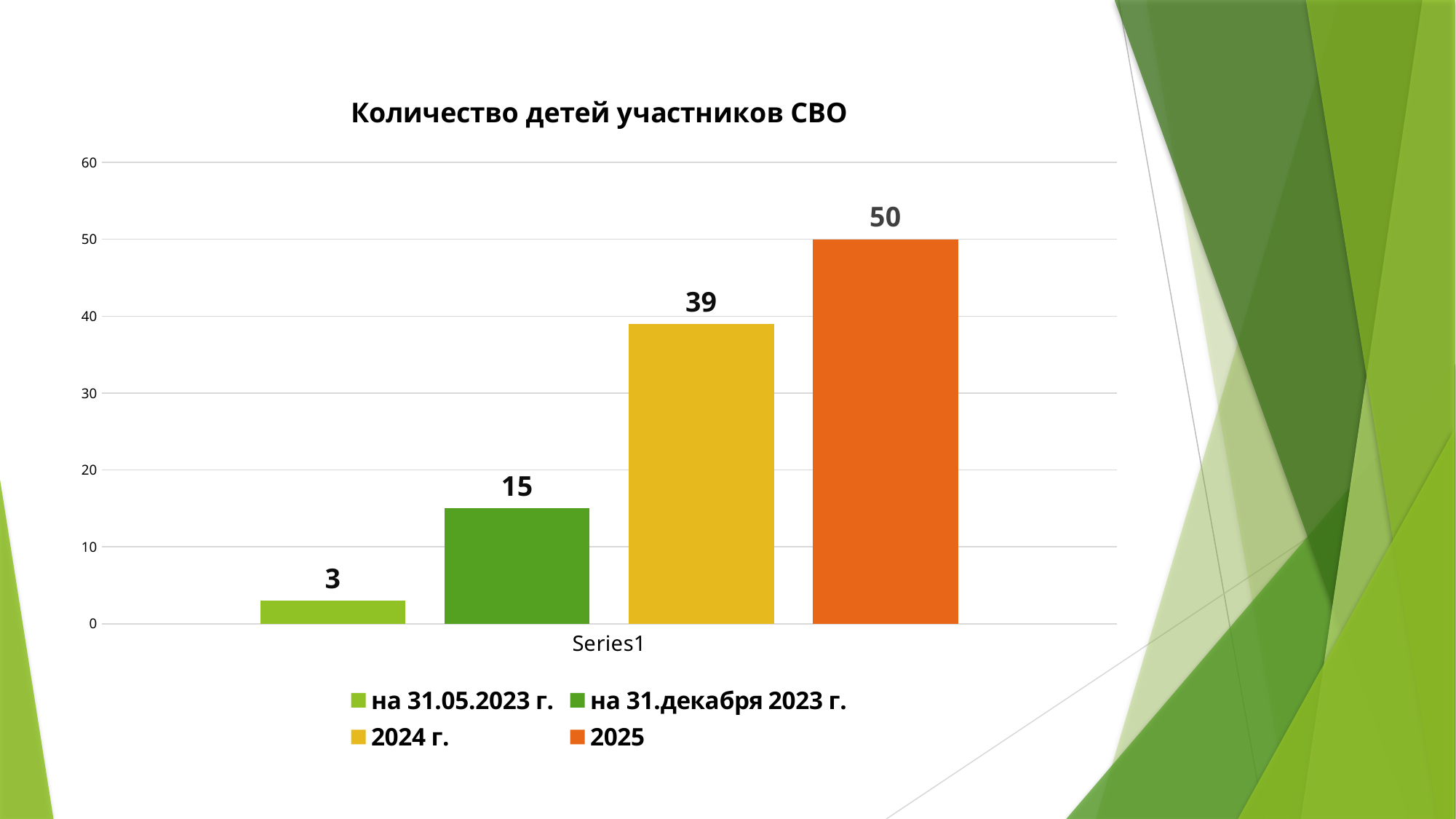
What kind of chart is shown on the slide? Bar chart What is the title of the chart? Количество детей участников СВО What is the value for "2025"? 50 What is the value for "на 31.декабря 2023 г."? 15 What is the value for "2024 г."? 39 Which series has the highest value? 2025 What is the value for "на 31.05.2023 г."? 3 What is the difference between the values for "2025" and "2024 г."? 11 What is the difference between the values for "на 31.декабря 2023 г." and "на 31.05.2023 г."? 12 How many series does the legend list? 4 Which series has the lowest value? на 31.05.2023 г. Which is larger, the value for "2024 г." or the value for "на 31.декабря 2023 г."? 2024 г.